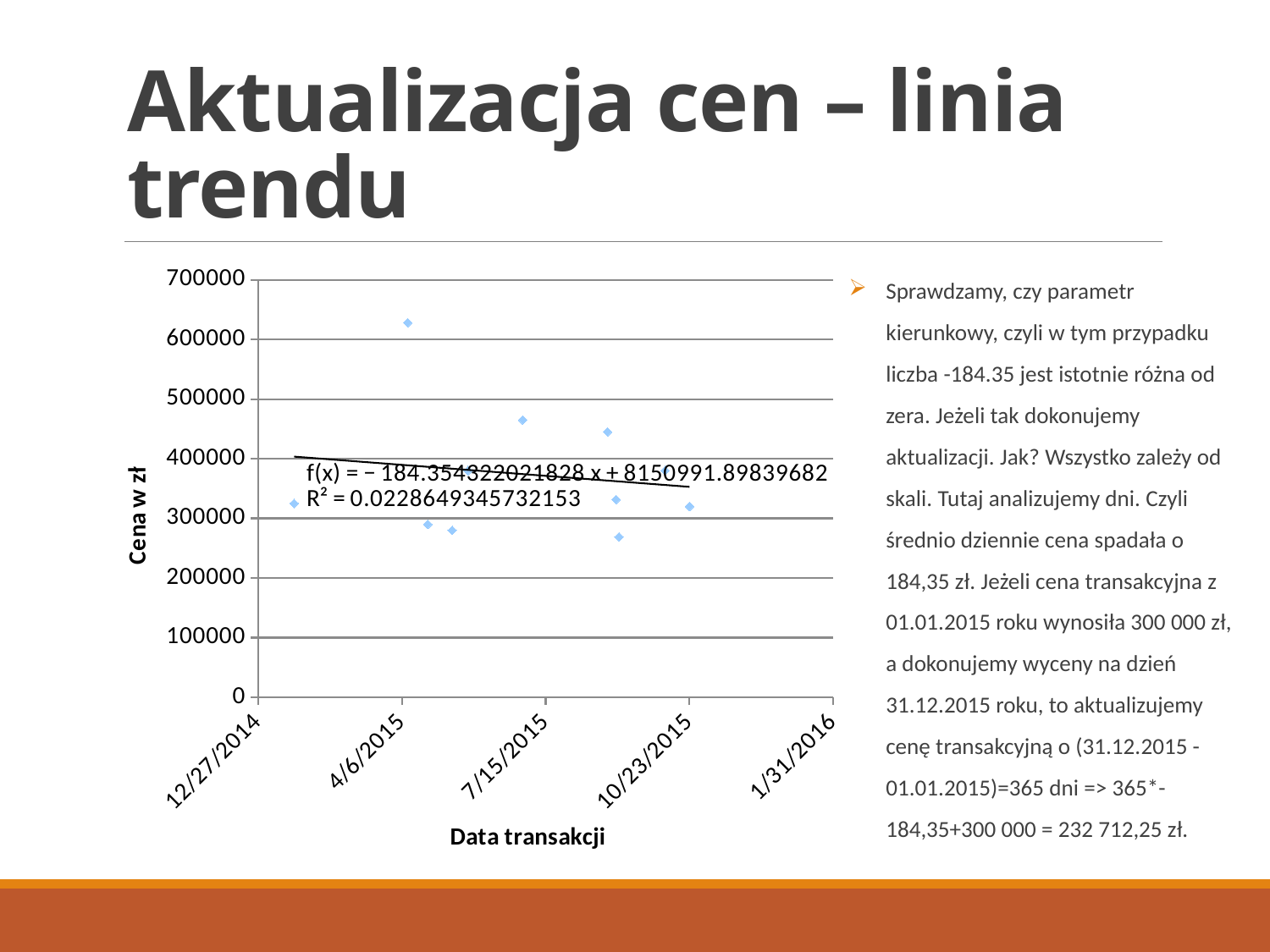
Is the lowest plotted point on the chart greater or less than 300000? less What kind of chart is shown on the slide? scatter chart What is the title of the horizontal axis of the chart? Data transakcji Is the highest plotted point on the chart greater or less than 600000? greater What is the trendline equation printed on the chart? f(x) = − 184.354322021828 x + 8150991.89839682 What R² value is printed on the chart? R² = 0.0228649345732153 Which date label appears first on the horizontal axis of the chart? 12/27/2014 Is the value of the point plotted near 12/27/2014 greater or less than 400000? less What is the maximum value shown on the vertical axis of the chart? 700000 What is the title of the vertical axis of the chart? Cena w zł Does the trendline on the chart rise or fall from left to right? fall